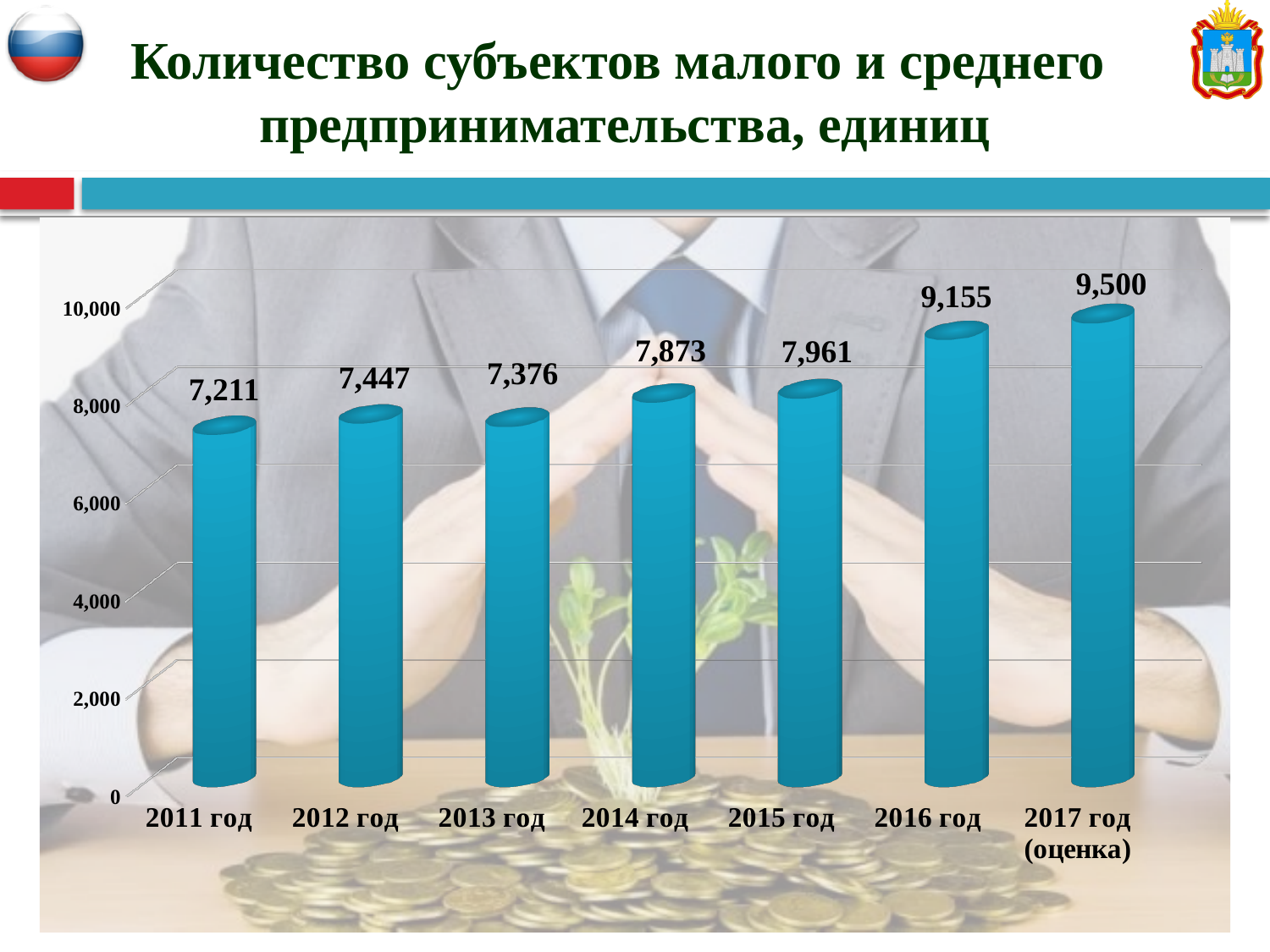
Which year has the highest value? 2017 год (оценка) How many years are shown on the x axis? 7 Which year has the lowest value? 2011 год Which is larger, the value for 2012 год or the value for 2013 год? 2012 год What is the difference between the values for 2016 год and 2015 год? 1,194 What kind of chart is shown on the slide? bar chart What is the value for 2011 год? 7,211 What is the difference between the values for 2017 год (оценка) and 2011 год? 2,289 What is the title of the chart? Количество субъектов малого и среднего предпринимательства, единиц What is the value for 2017 год (оценка)? 9,500 Is the value for 2016 год greater or less than 8,000? greater What is the value for 2014 год? 7,873